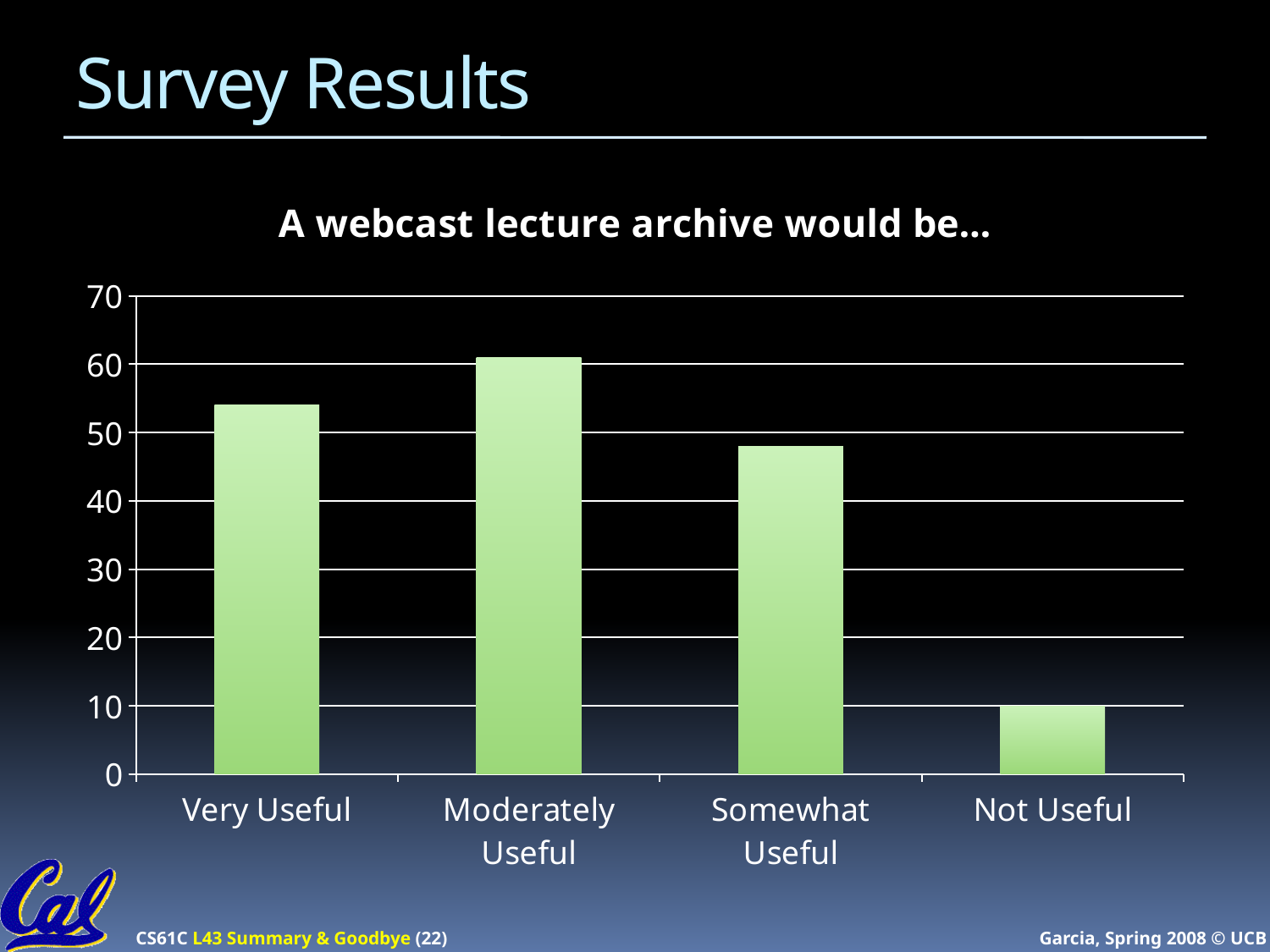
Which category has the highest bar? Moderately Useful Which is larger, the value for Very Useful or the value for Somewhat Useful? Very Useful Is the value for Somewhat Useful greater or less than 50? less Is the value for Very Useful greater or less than 50? greater What is the value for Not Useful? 10 How many categories are shown on the x axis of the chart? 4 What is the highest value shown on the y axis of the chart? 70 What kind of chart is shown on the slide? bar chart Is the value for Moderately Useful greater or less than 50? greater What is the title of the chart? A webcast lecture archive would be… Which category has the lowest bar? Not Useful